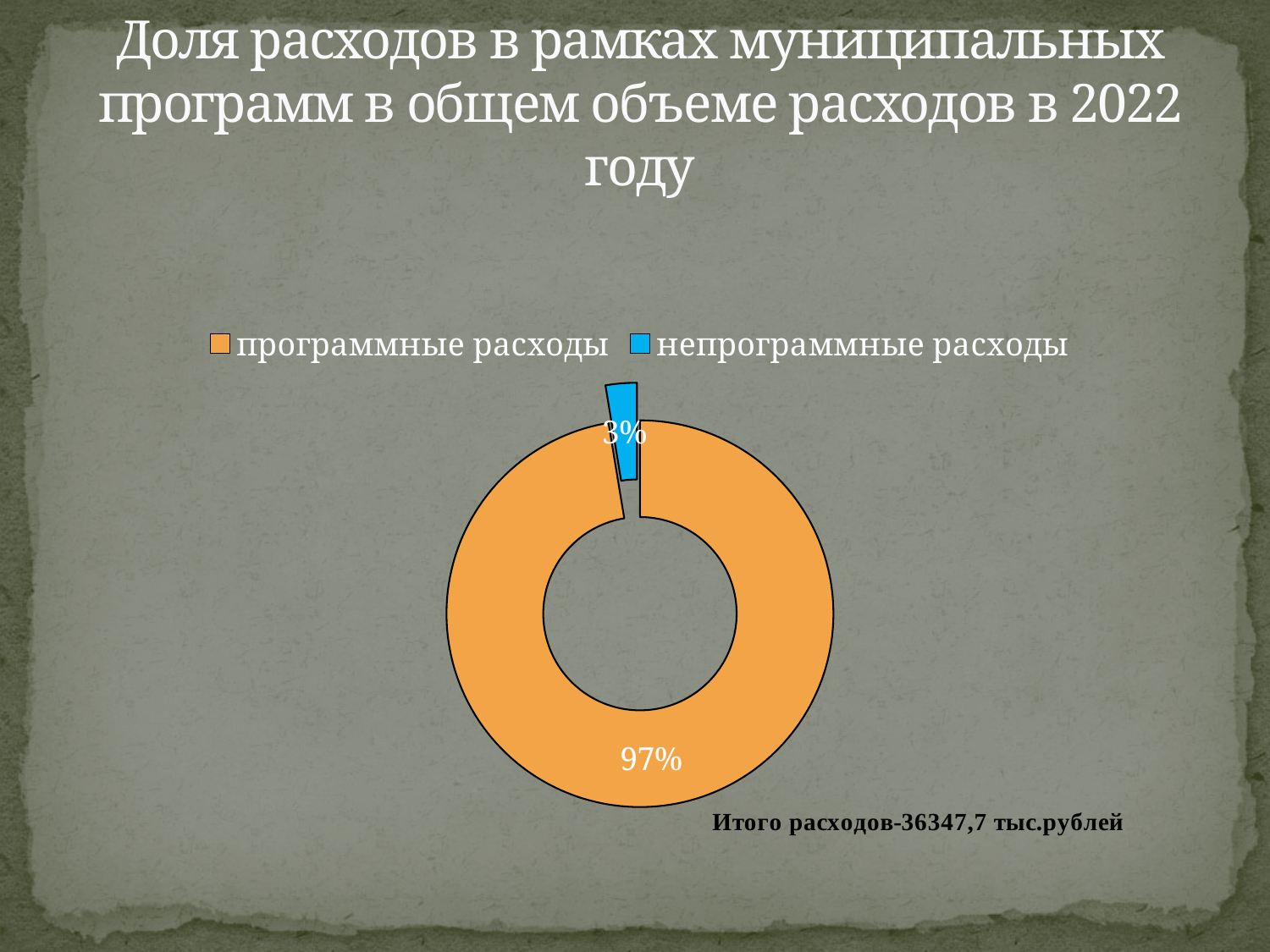
Which is larger: программные расходы or непрограммные расходы? программные расходы What kind of chart is shown on the slide? doughnut (pie) chart What share of the chart is labelled for программные расходы? 97% How many categories does the chart show? 2 What total expenditure is stated in the note below the chart? 36347,7 тыс.рублей What share of the chart is labelled for непрограммные расходы? 3% How many entries does the legend list? 2 Which category has the largest share of the chart? программные расходы What is the difference in percentage points between программные расходы and непрограммные расходы? 94 percentage points Which category has the smallest share of the chart? непрограммные расходы What colour is the slice for непрограммные расходы? blue